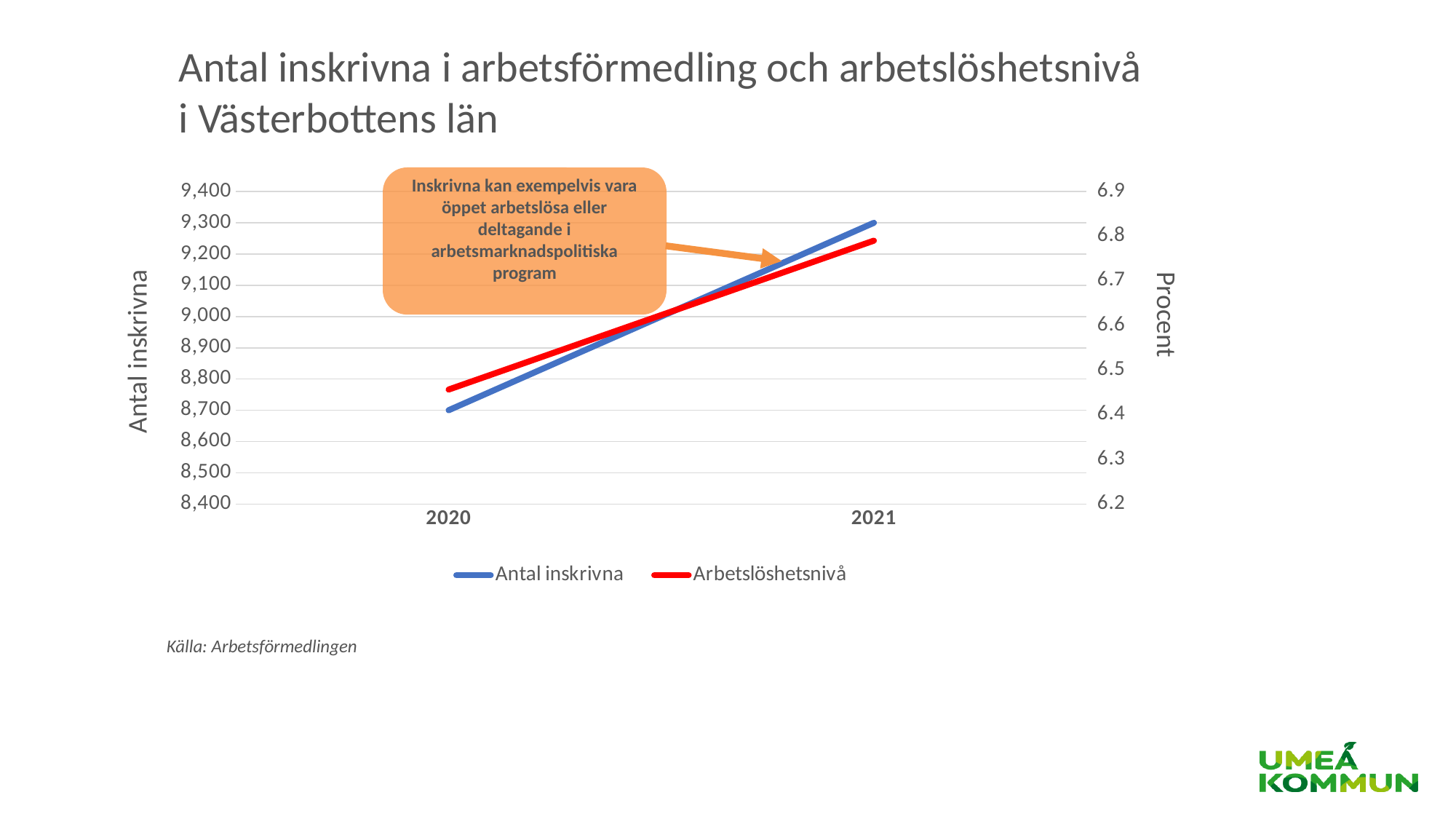
What is the value of Antal inskrivna in 2021? 9,300 Which series is drawn in red according to the legend? Arbetslöshetsnivå What is the value of Antal inskrivna in 2020? 8,700 Is the Arbetslöshetsnivå value for 2021 greater or less than 6.7? greater Does the Arbetslöshetsnivå line rise or fall from 2020 to 2021? rise How many years are plotted along the x axis? 2 Is the Arbetslöshetsnivå value for 2020 greater or less than 6.5? less Which year has the higher value for Antal inskrivna, 2020 or 2021? 2021 What is the title of the right-hand vertical axis? Procent How many series does the legend list? 2 Does the Antal inskrivna line rise or fall from 2020 to 2021? rise What kind of chart is shown on the slide? line chart